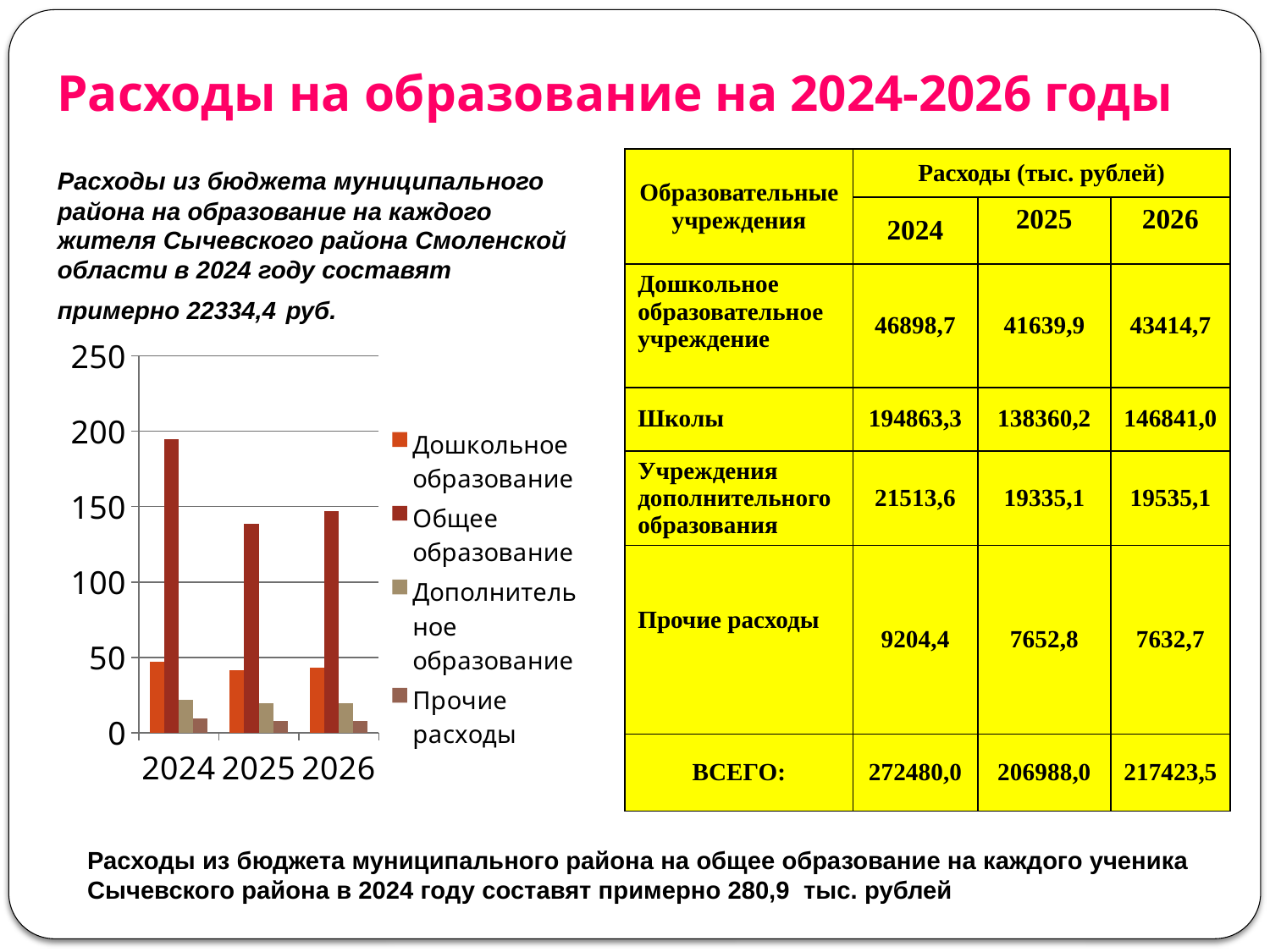
How many years are shown on the x axis of the chart? 3 Does the value for Общее образование rise or fall from 2024 to 2025? fall Which is larger: Общее образование in 2025 or in 2026? 2026 Is the value for Дошкольное образование in 2024 greater or less than 100? less What kind of chart is shown on the slide? bar chart Which series has the lowest bars in every year? Прочие расходы Is the value for Общее образование in 2024 greater or less than 150? greater What is the title of the slide containing the chart? Расходы на образование на 2024-2026 годы In which year is the bar for Общее образование the highest? 2024 How many series does the chart legend list? 4 Is the value for Общее образование in 2025 greater or less than 100? greater Which is larger in 2024: Дошкольное образование or Дополнительное образование? Дошкольное образование